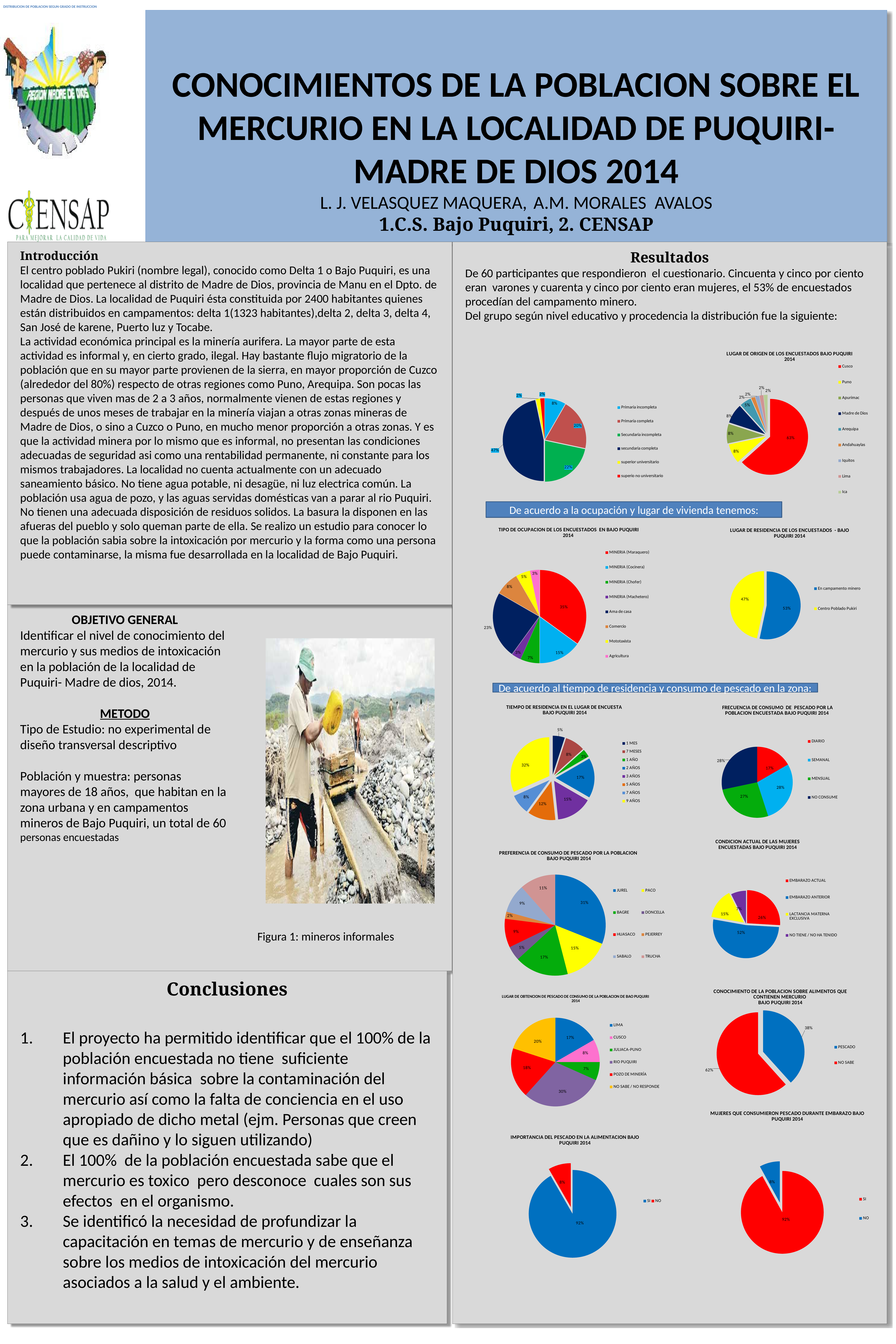
In the chart 'CONOCIMIENTO DE LA POBLACION SOBRE ALIMENTOS QUE CONTIENEN MERCURIO BAJO PUQUIRI 2014', what percentage answered NO SABE? 62% In the chart 'TIEMPO DE RESIDENCIA EN EL LUGAR DE ENCUESTA BAJO PUQUIRI 2014', what percentage corresponds to 9 AÑOS? 32% In the chart 'FRECUENCIA DE CONSUMO DE PESCADO POR LA POBLACION ENCUESTADA BAJO PUQUIRI 2014', how many categories does the legend list? 4 In the chart 'CONDICION ACTUAL DE LAS MUJERES ENCUESTADAS BAJO PUQUIRI 2014', what is the difference between the shares for EMBARAZO ANTERIOR and EMBARAZO ACTUAL? 26% In the chart 'LUGAR DE OBTENCION DE PESCADO DE CONSUMO DE LA POBLACION DE BAO PUQUIRI 2014', which is larger: the share for RIO PUQUIRI or the share for LIMA? RIO PUQUIRI In the chart 'LUGAR DE ORIGEN DE LOS ENCUESTADOS BAJO PUQUIRI 2014', what percentage of respondents came from Cusco? 63% In the chart 'TIPO DE OCUPACION DE LOS ENCUESTADOS EN BAJO PUQUIRI 2014', which occupation has the largest share? MINERIA (Maraquero) In the chart 'LUGAR DE RESIDENCIA DE LOS ENCUESTADOS - BAJO PUQUIRI 2014', what share of respondents live 'En campamento minero'? 53% What type of chart is 'MUJERES QUE CONSUMIERON PESCADO DURANTE EMBARAZO BAJO PUQUIRI 2014'? Pie chart In the first pie chart on the left of the Resultados section (education level), what percentage corresponds to 'secundaria completa'? 47% In the chart 'PREFERENCIA DE CONSUMO DE PESCADO POR LA POBLACION BAJO PUQUIRI 2014', which fish has the smallest share? PEJERREY In the chart 'IMPORTANCIA DEL PESCADO EN LA ALIMENTACION BAJO PUQUIRI 2014', what percentage answered SI? 92%